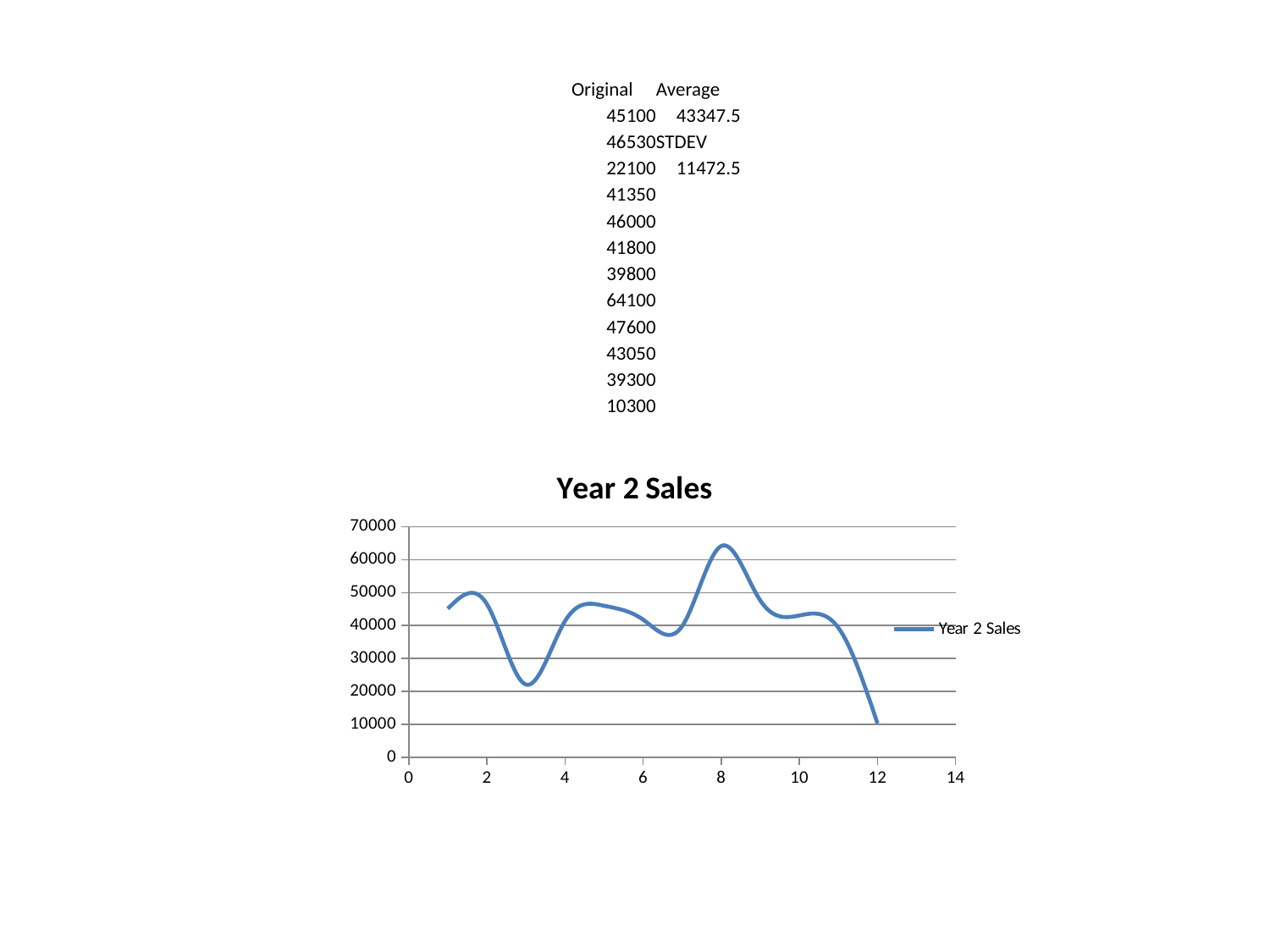
At which x value does the Year 2 Sales line reach its highest point? 8 Is the value for Year 2 Sales at x = 3 greater or less than 30000? less How many series does the chart legend list? 1 Is the value for Year 2 Sales at x = 8 greater or less than 60000? greater Does the Year 2 Sales line rise or fall between x = 8 and x = 12? fall Is the value for Year 2 Sales at x = 12 greater or less than 20000? less At which x value does the Year 2 Sales line reach its lowest point? 12 What is the name of the series shown in the chart legend? Year 2 Sales What kind of chart is shown on the slide? line chart What is the title of the chart? Year 2 Sales Which has the larger Year 2 Sales value, x = 8 or x = 3? x = 8